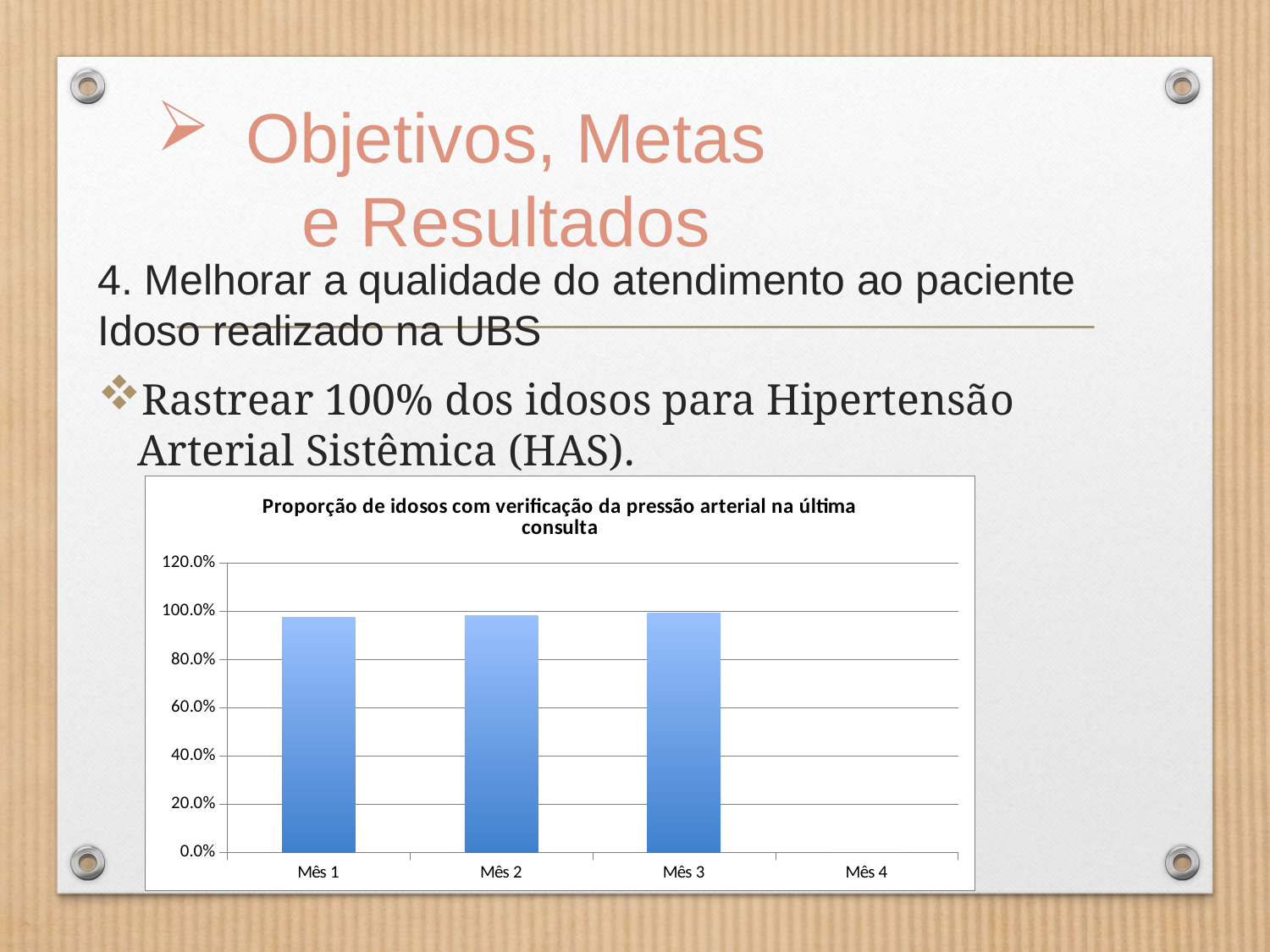
Is the value for Mês 1 greater or less than 60.0%? greater Is the value for Mês 1 greater or less than 100.0%? less Is the value for Mês 2 greater or less than 80.0%? greater What is the highest value shown on the y axis of the chart? 120.0% What is the title of the chart? Proporção de idosos com verificação da pressão arterial na última consulta Which category on the x axis has no visible bar? Mês 4 How many categories are shown on the x axis of the chart? 4 What kind of chart is shown on the slide? bar chart